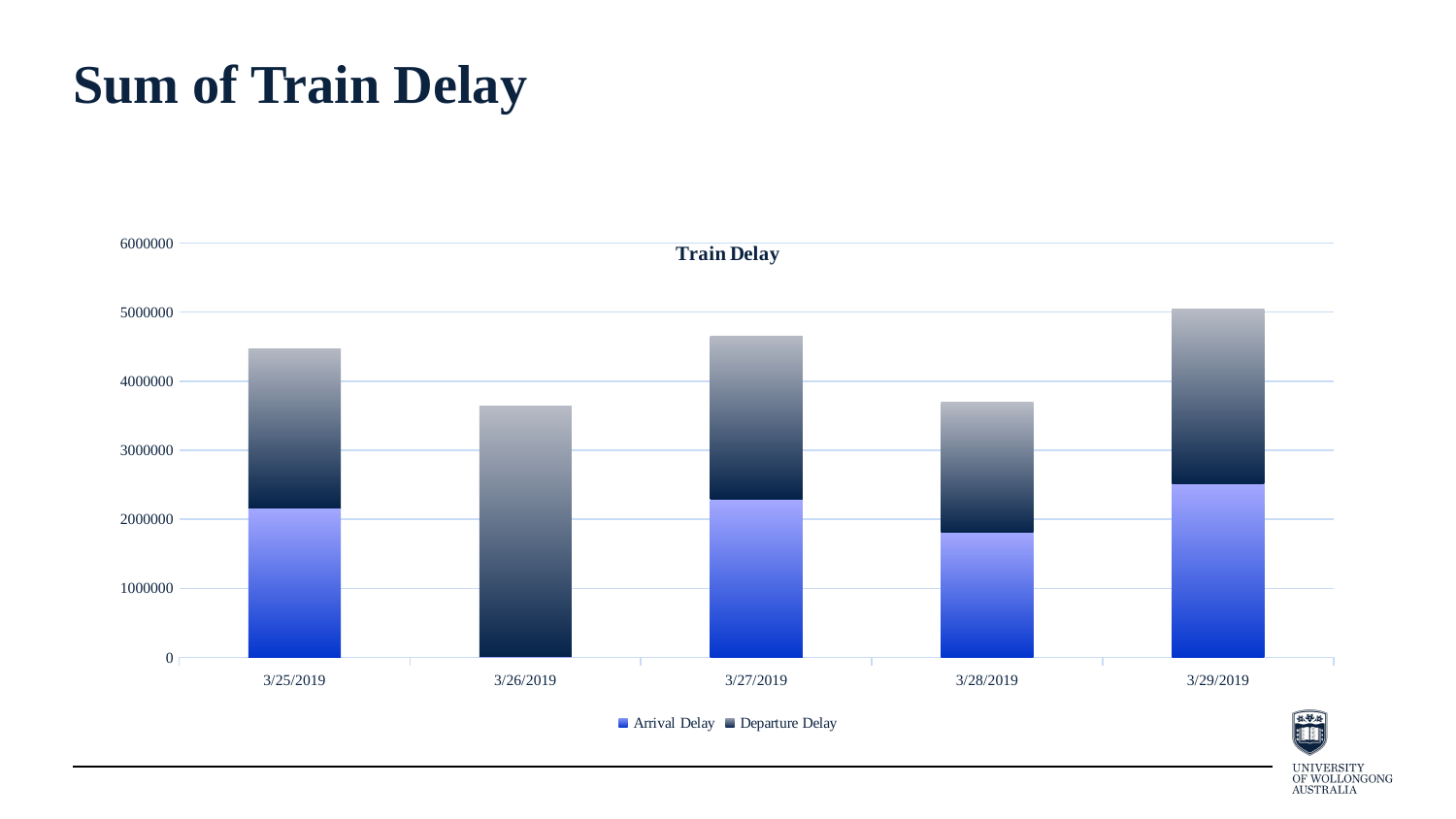
Which has the larger total train delay, 3/25/2019 or 3/26/2019? 3/25/2019 Which date has the highest Arrival Delay? 3/29/2019 Which date has the highest total train delay? 3/29/2019 Is the Arrival Delay for 3/25/2019 greater or less than 2000000? greater What are the two series named in the chart legend? Arrival Delay and Departure Delay Is the Arrival Delay for 3/28/2019 greater or less than 2000000? less Is the total train delay for 3/29/2019 greater or less than 4000000? greater How many series does the legend list? 2 How many dates are shown on the x axis of the chart? 5 What kind of chart is shown on the slide? Stacked bar chart Which has the larger Arrival Delay, 3/27/2019 or 3/28/2019? 3/27/2019